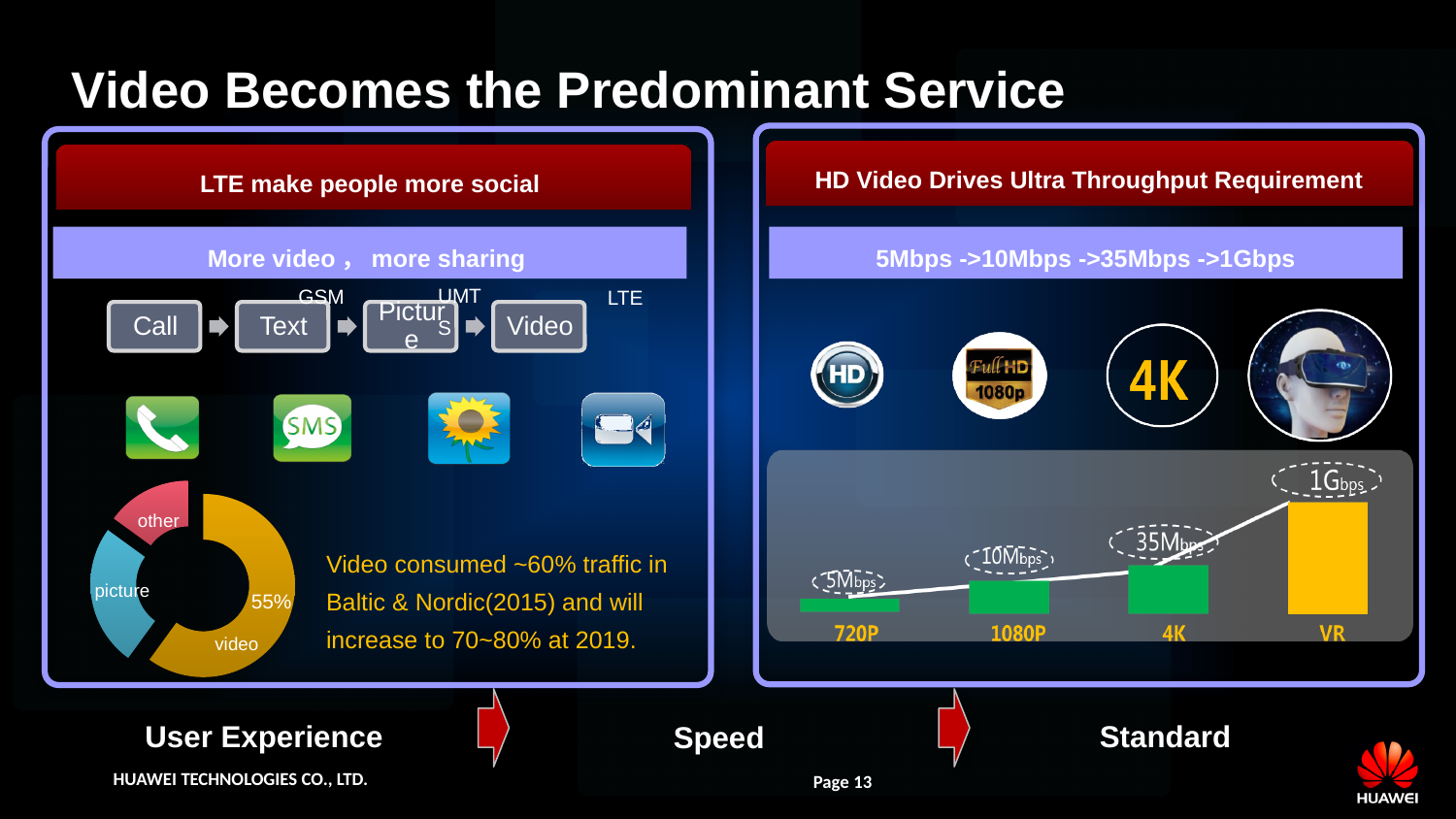
In the donut chart on the left, which slice is the largest? video In the bar chart on the right, what throughput is labelled for VR? 1Gbps How many categories are shown in the bar chart on the right? 4 In the bar chart on the right, what is the difference between the throughput for 4K and for 1080P? 25Mbps In the bar chart on the right, what throughput is labelled for 4K? 35Mbps What kind of chart is shown on the right side of the slide? bar chart In the bar chart on the right, which has the larger throughput, 1080P or 4K? 4K In the bar chart on the right, which category has the lowest throughput? 720P In the bar chart on the right, what throughput is labelled for 720P? 5Mbps In the bar chart on the right, do the values rise or fall from 720P to VR? rise In the donut chart on the left, what share is labelled for video? 55% In the bar chart on the right, which category has the highest throughput? VR